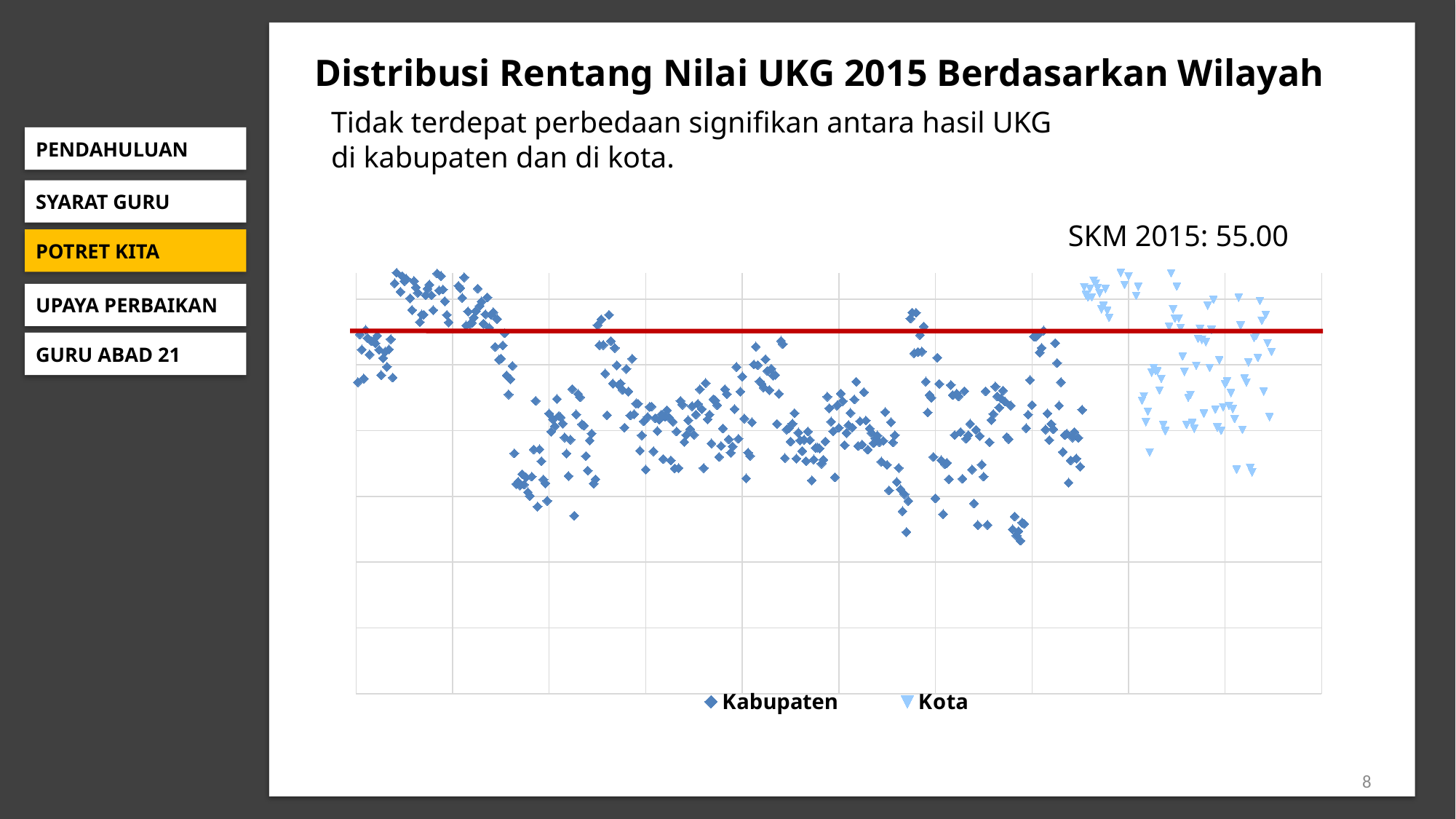
What is the title of the chart on the slide? Distribusi Rentang Nilai UKG 2015 Berdasarkan Wilayah What are the two series named in the chart legend? Kabupaten and Kota What kind of chart is shown on the slide? scatter chart How many series does the chart legend list? 2 Are most of the Kabupaten points plotted above or below the red horizontal line? below Which series has more plotted points, Kabupaten or Kota? Kabupaten What SKM 2015 value is printed above the chart? 55.00